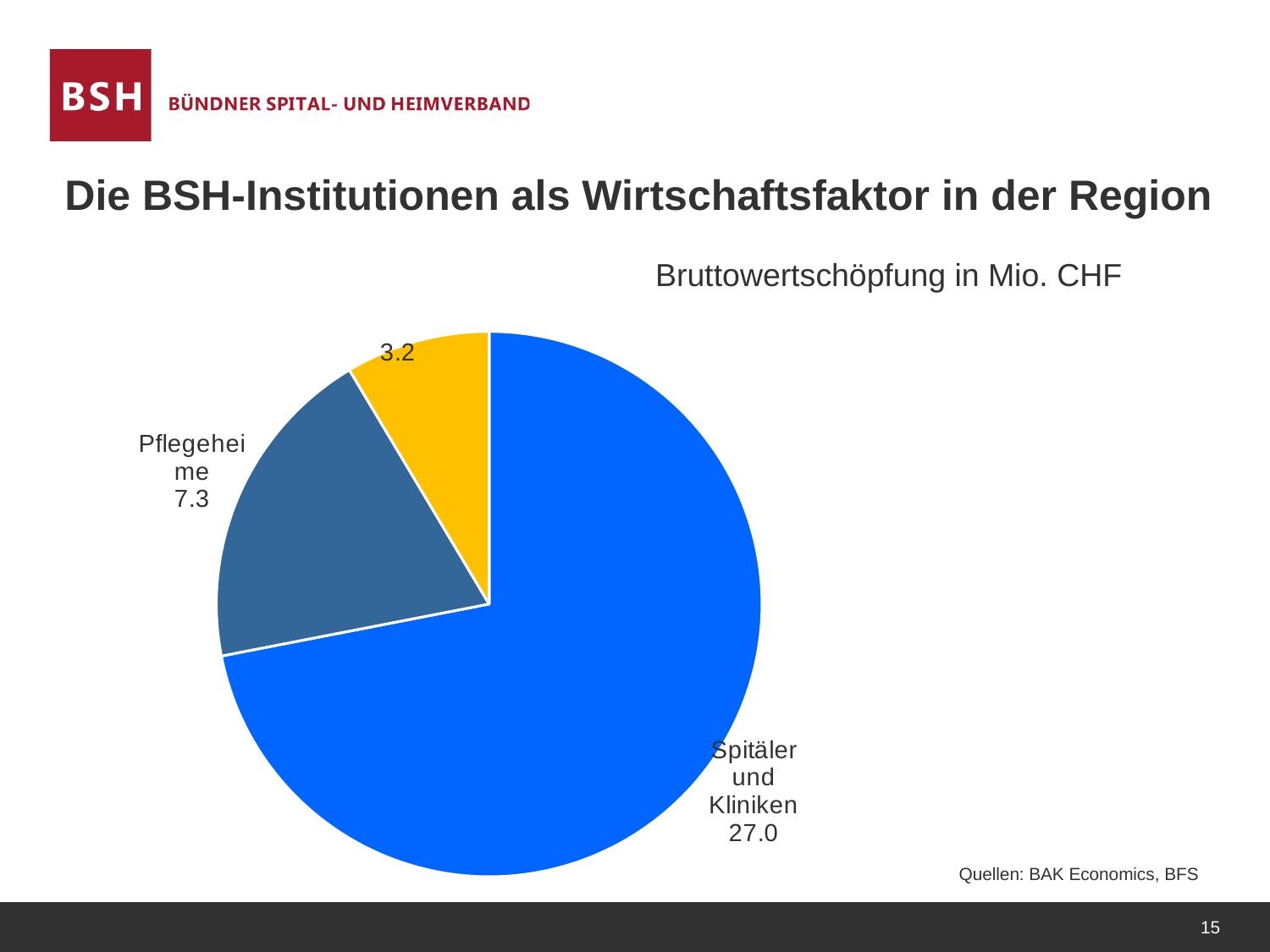
What is the difference between the values for Spitäler und Kliniken and Pflegeheime? 19.7 What is the total of all slices in the pie chart? 37.5 Which is larger, the value for Pflegeheime or the value of the yellow slice? Pflegeheime What is the title of the pie chart? Bruttowertschöpfung in Mio. CHF What colour is the slice for Spitäler und Kliniken? Blue Which category has the largest slice of the pie chart? Spitäler und Kliniken What share of the pie does Spitäler und Kliniken represent? 72% What is the value of the smallest slice in the pie chart? 3.2 What kind of chart is shown on the slide? Pie chart How many slices does the pie chart have? 3 What is the value shown for Pflegeheime in the pie chart? 7.3 What is the value shown for Spitäler und Kliniken in the pie chart? 27.0